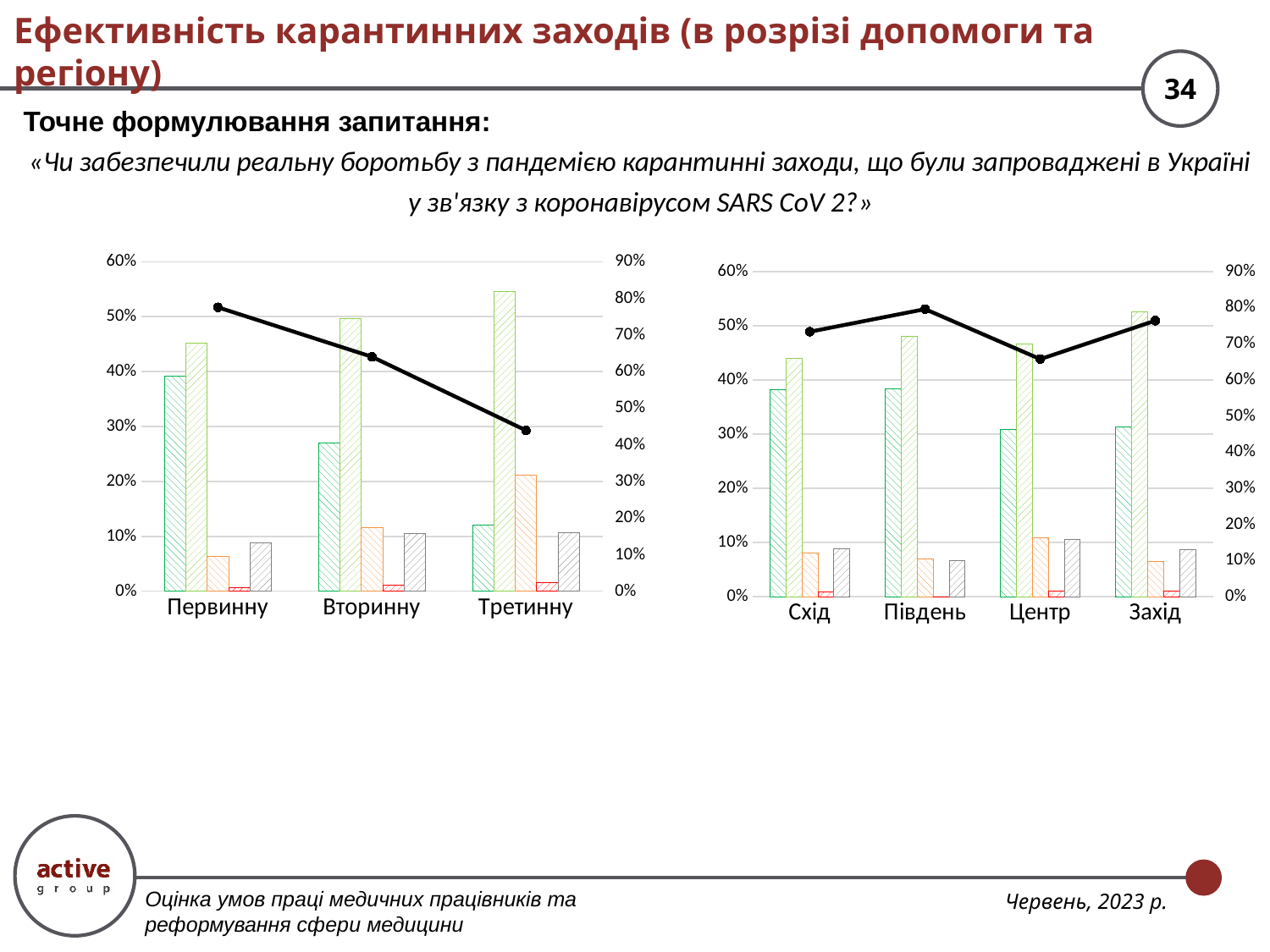
On the right chart, how many categories are shown on the x axis? 4 On the left chart, which category has the tallest bar? Третинну On the left chart, is the black line value for Вторинну higher or lower than for Третинну? Higher On the left chart, how many categories are shown on the x axis? 3 On the left chart, is the black line value for Третинну (right axis) greater or less than 50%? less On the right chart, which category has the highest value on the black line? Південь What is the maximum value shown on the left-hand axis of the right chart? 60% On the right chart, is the black line value for Центр (right axis) greater or less than 70%? less What kind of chart is the left chart? Combined bar and line chart On the right chart, which category has the lowest value on the black line? Центр On the left chart, does the black line rise or fall from Первинну to Третинну? Falls On the left chart, is the black line value for Первинну (right axis) greater or less than 70%? greater